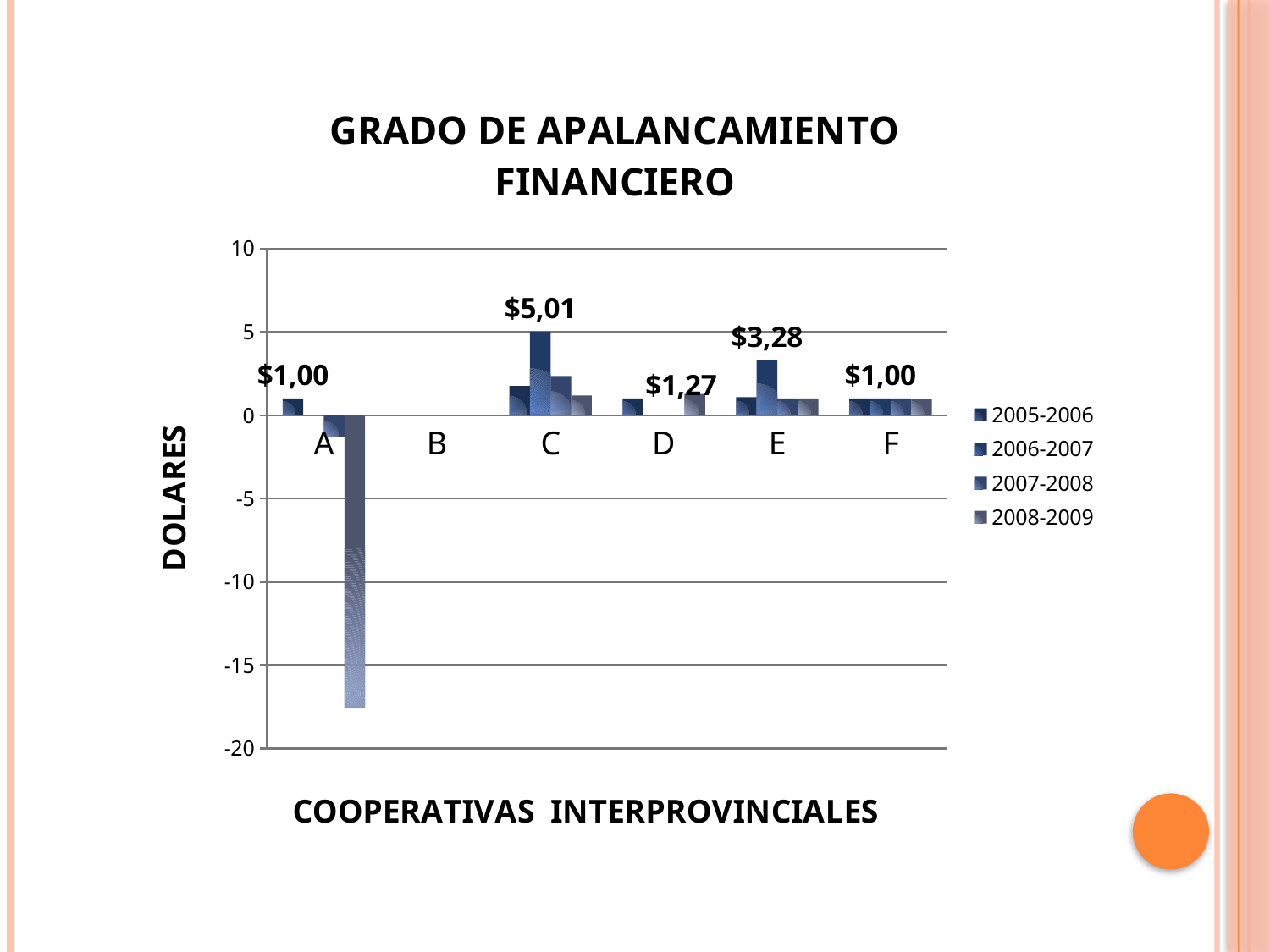
Is the lowest bar for category A (2008-2009) greater or less than -15? less What value is labelled for category D? $1,27 What is the title of the chart? GRADO DE APALANCAMIENTO FINANCIERO What is the label of the vertical axis? DOLARES What is the highest value labelled on the chart, and for which category? $5,01 for C How many series does the legend list? 4 What kind of chart is shown on the slide? Bar chart What value is labelled for category F? $1,00 What is the difference between the labelled value for C ($5,01) and the labelled value for E ($3,28)? $1,73 How many cooperative categories are shown on the x axis? 6 Which is larger, the labelled value for C or the labelled value for E? C What value is labelled above the tallest bar for category E? $3,28